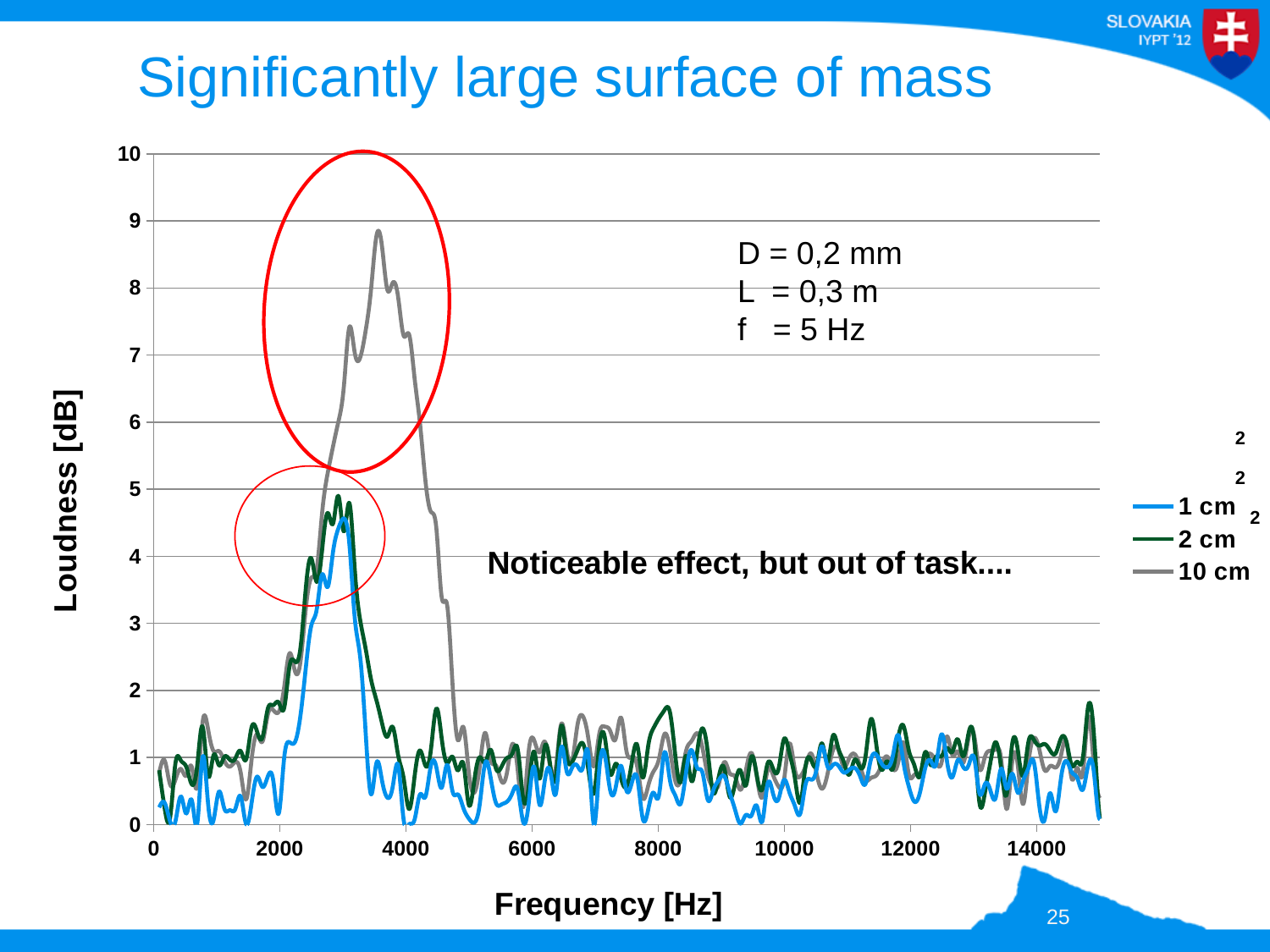
Which series reaches the highest loudness? 10 cm How many series does the legend list? 3 Which series has a higher peak loudness, 2 cm or 10 cm? 10 cm What is the label of the y axis? Loudness [dB] Is the peak loudness of the 2 cm series greater or less than 4? greater Does the peak of the 10 cm series occur at a frequency greater or less than 4000 Hz? less At 10000 Hz, are the loudness values of all three series greater or less than 2? less What is the label of the x axis? Frequency [Hz] What kind of chart is shown on the slide? line chart